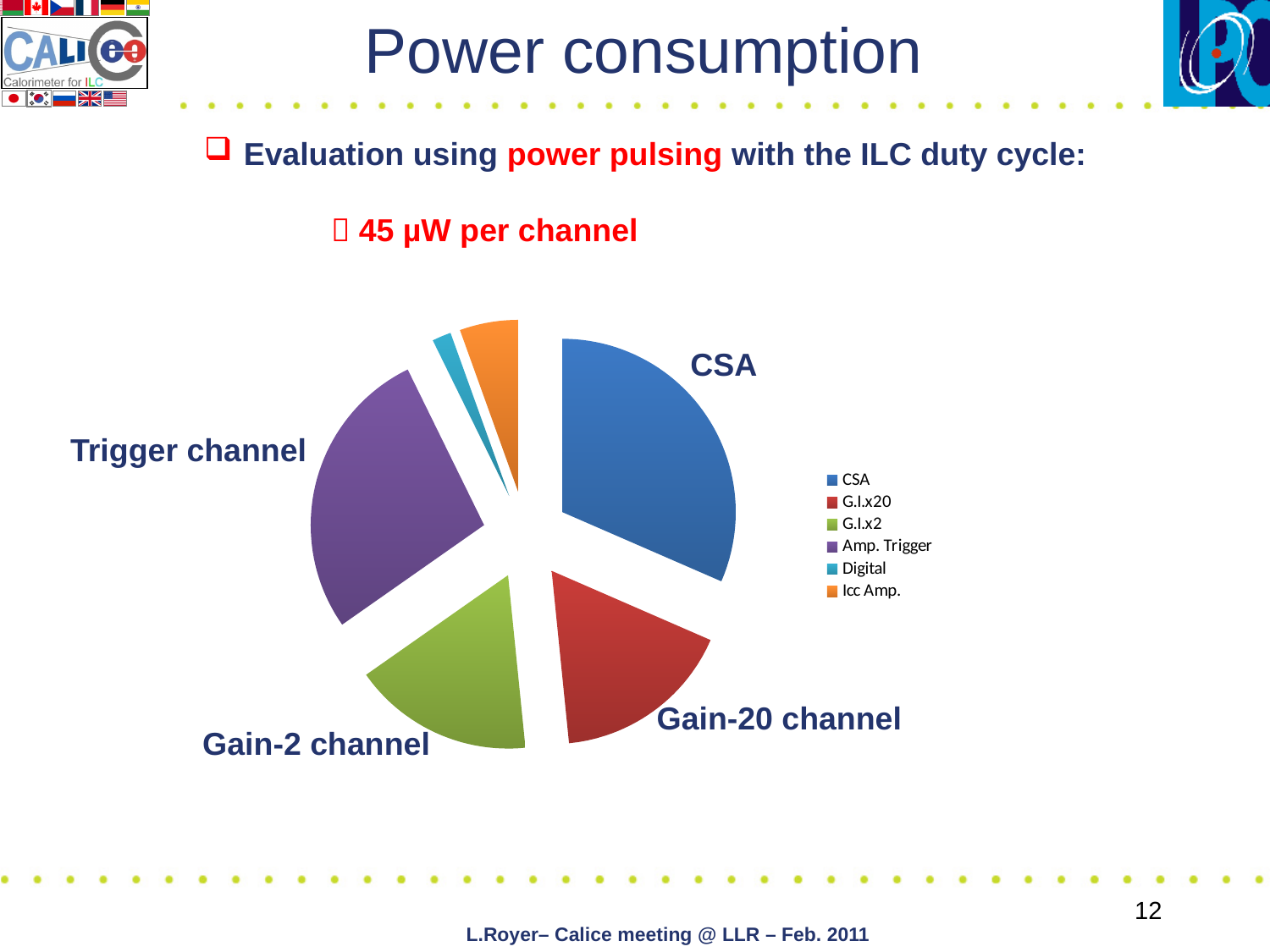
Which slice is larger in the pie chart, Digital or Icc Amp.? Icc Amp. Which slice is larger in the pie chart, Amp. Trigger or Digital? Amp. Trigger How many entries does the legend of the pie chart list? 6 Which slice of the pie chart is the smallest? Digital Which legend entry is shown in orange in the pie chart? Icc Amp. Which slice is larger in the pie chart, CSA or Digital? CSA What kind of chart is shown on the slide? pie chart How many slices does the pie chart have? 6 What colour is the CSA slice in the pie chart? blue